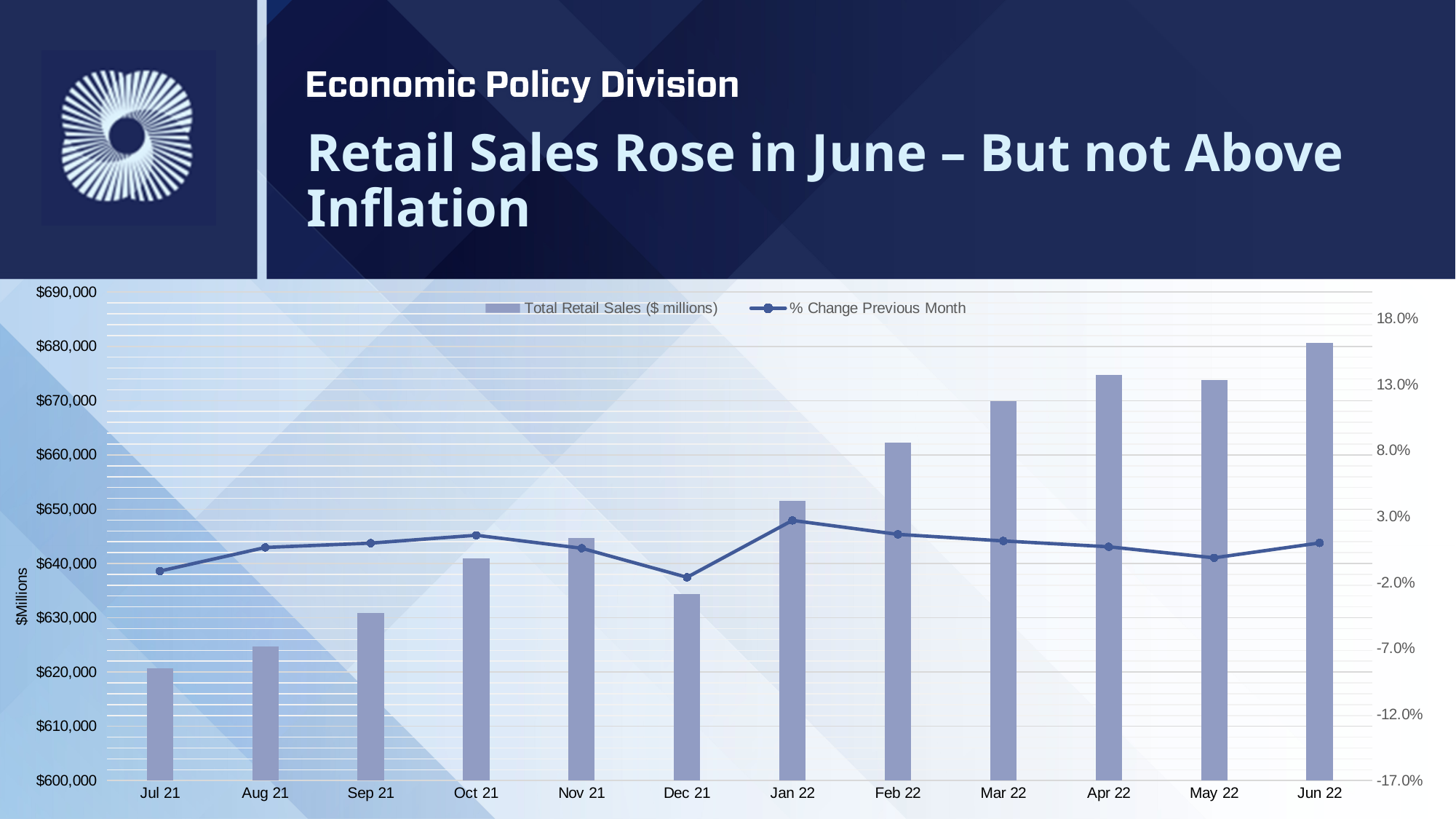
What kind of chart is shown on the slide? Combination bar and line chart Is the Total Retail Sales value for Dec 21 greater or less than $640,000? less Which month has the highest point on the % Change Previous Month line? Jan 22 Is the Total Retail Sales value for Jul 21 greater or less than $630,000? less How many months are shown on the x axis of the chart? 12 Which month has the highest Total Retail Sales bar? Jun 22 Which month has the lowest point on the % Change Previous Month line? Dec 21 Which month has the larger Total Retail Sales bar, Nov 21 or Dec 21? Nov 21 How many series does the chart legend list? 2 Which month has the lowest Total Retail Sales bar? Jul 21 Is the Total Retail Sales value for Jun 22 greater or less than $670,000? greater Do the Total Retail Sales bars generally rise or fall from Jul 21 to Jun 22? rise